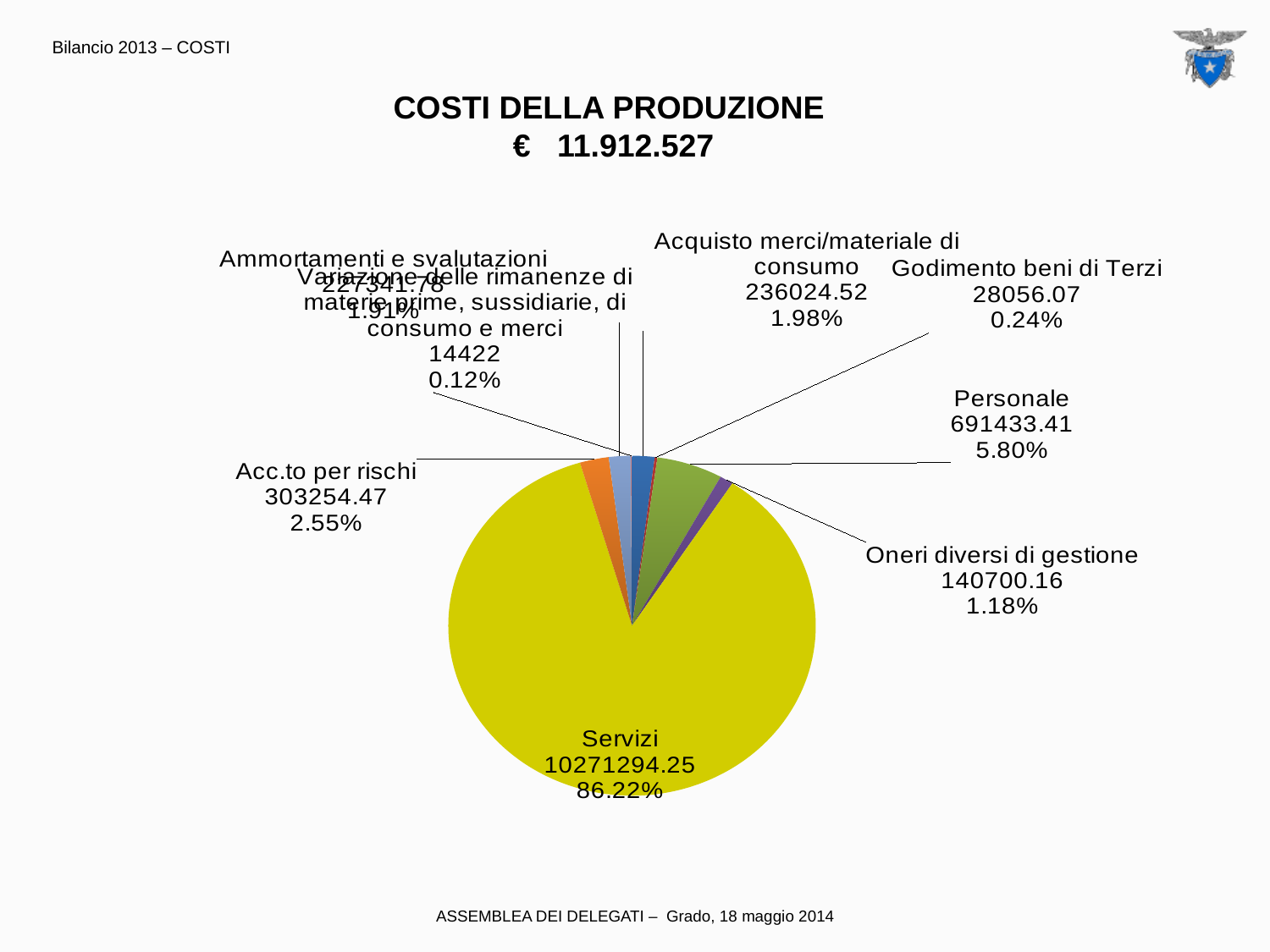
What is the value shown for Acc.to per rischi? 303254.47 Which category has the smallest slice of the pie? Variazione delle rimanenze di materie prime, sussidiarie, di consumo e merci What percentage share does Personale have? 5.80% What is the value shown for Servizi? 10271294.25 What percentage share does Godimento beni di Terzi have? 0.24% What is the value shown for Personale? 691433.41 What is the value shown for Oneri diversi di gestione? 140700.16 What is the total amount stated in the chart title? € 11.912.527 What kind of chart is shown on the slide? pie chart Which is larger, Personale or Acquisto merci/materiale di consumo? Personale Which category has the largest slice of the pie? Servizi What percentage share of the pie does Servizi represent? 86.22%